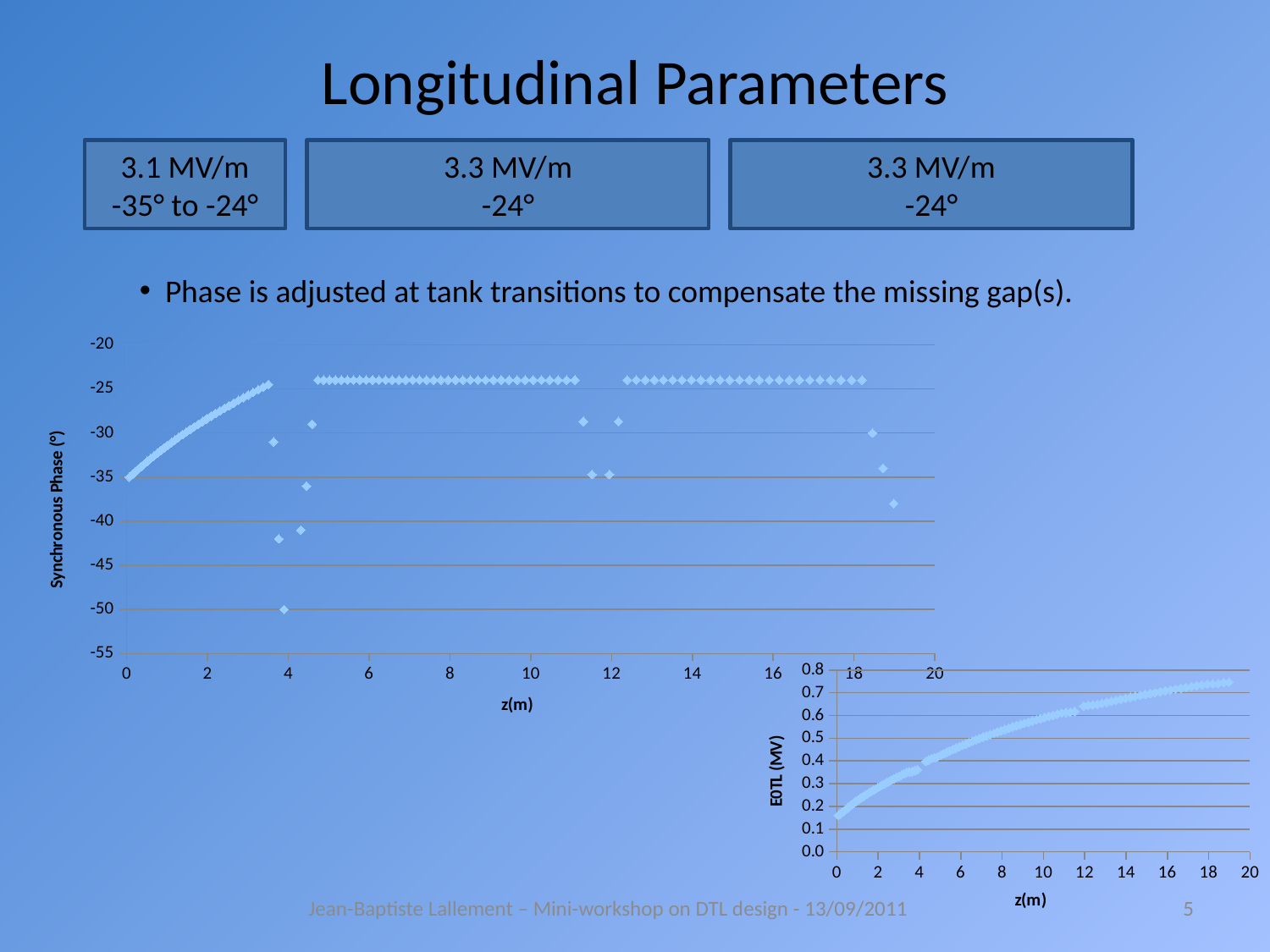
In the E0TL chart, which is larger: the value at z = 4 or the value at z = 14? the value at z = 14 What kind of chart is the chart with the y axis labelled Synchronous Phase (°)? scatter chart What kind of chart is the chart with the y axis labelled E0TL (MV)? scatter chart In the Synchronous Phase chart, is the value at z = 8 greater or less than -30? greater In the Synchronous Phase chart, do the values rise or fall between z = 0 and z = 3? rise In the E0TL chart, what is the label of the y axis? E0TL (MV) In the E0TL chart, do the values rise or fall as z increases? rise In the Synchronous Phase chart, which is larger: the value at z = 1 or the value at z = 8? the value at z = 8 In the E0TL chart, is the value at z = 18 greater or less than 0.6? greater In the Synchronous Phase chart, is the lowest plotted point greater or less than -45? less In the Synchronous Phase chart, what is the label of the x axis? z(m)